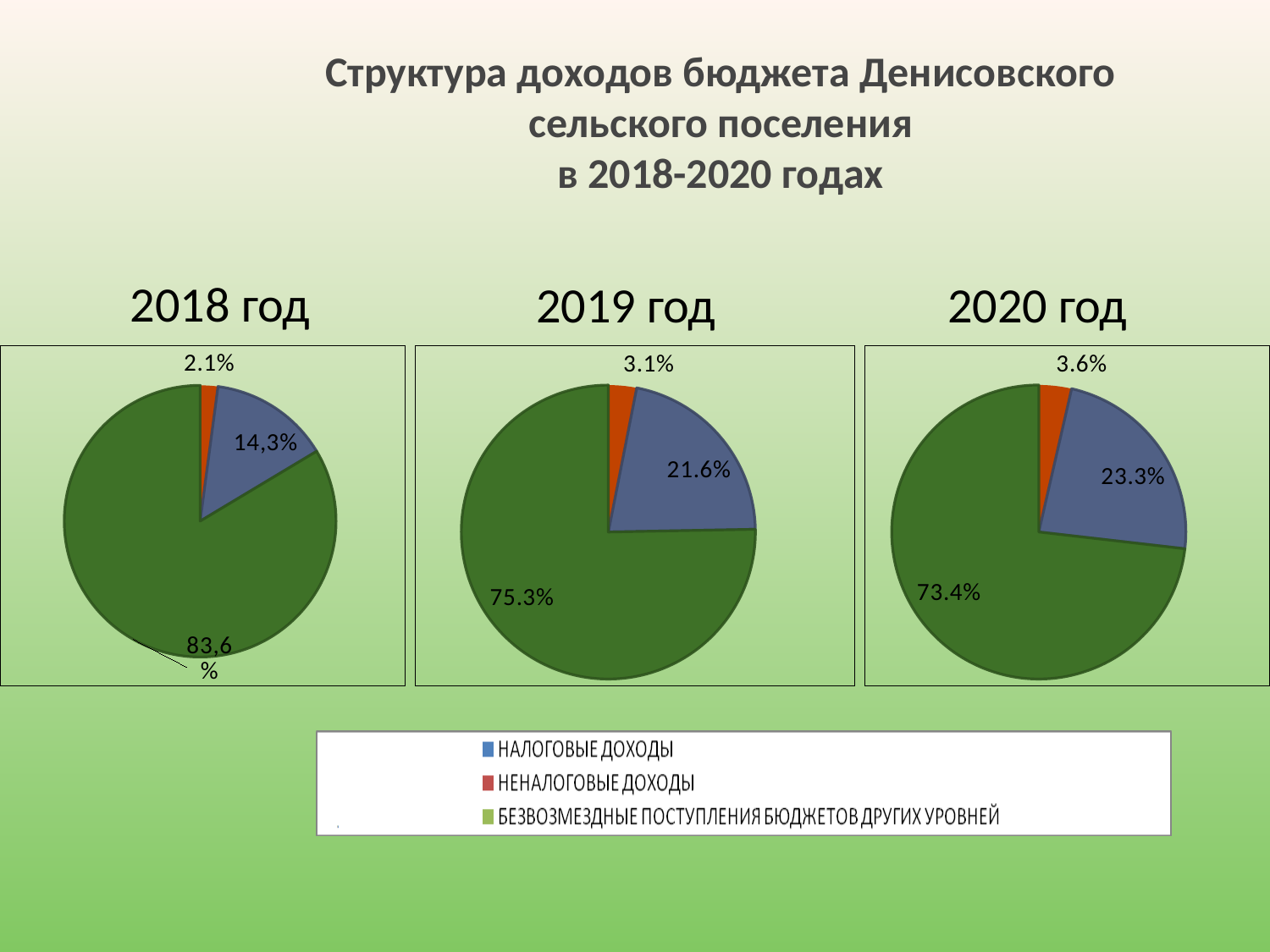
In the 2020 год pie chart, what share is shown for НЕНАЛОГОВЫЕ ДОХОДЫ? 3.6% In the 2020 год pie chart, what share is shown for НАЛОГОВЫЕ ДОХОДЫ? 23.3% In the 2020 год pie chart, which category has the smallest slice? НЕНАЛОГОВЫЕ ДОХОДЫ Is the НАЛОГОВЫЕ ДОХОДЫ share larger in the 2018 год chart or in the 2019 год chart? 2019 год How many slices does each pie chart on the slide have? 3 In the 2019 год pie chart, what share is shown for БЕЗВОЗМЕЗДНЫЕ ПОСТУПЛЕНИЯ БЮДЖЕТОВ ДРУГИХ УРОВНЕЙ? 75.3% Which colour represents НЕНАЛОГОВЫЕ ДОХОДЫ in the legend? Red What is the difference between the НАЛОГОВЫЕ ДОХОДЫ share in the 2020 год chart and in the 2019 год chart? 1.7% In the 2018 год pie chart, what share is shown for НАЛОГОВЫЕ ДОХОДЫ? 14,3% In the 2019 год pie chart, which category has the largest slice? БЕЗВОЗМЕЗДНЫЕ ПОСТУПЛЕНИЯ БЮДЖЕТОВ ДРУГИХ УРОВНЕЙ In the 2018 год pie chart, what share is shown for НЕНАЛОГОВЫЕ ДОХОДЫ? 2.1% What type of chart is used for each year on the slide? Pie chart